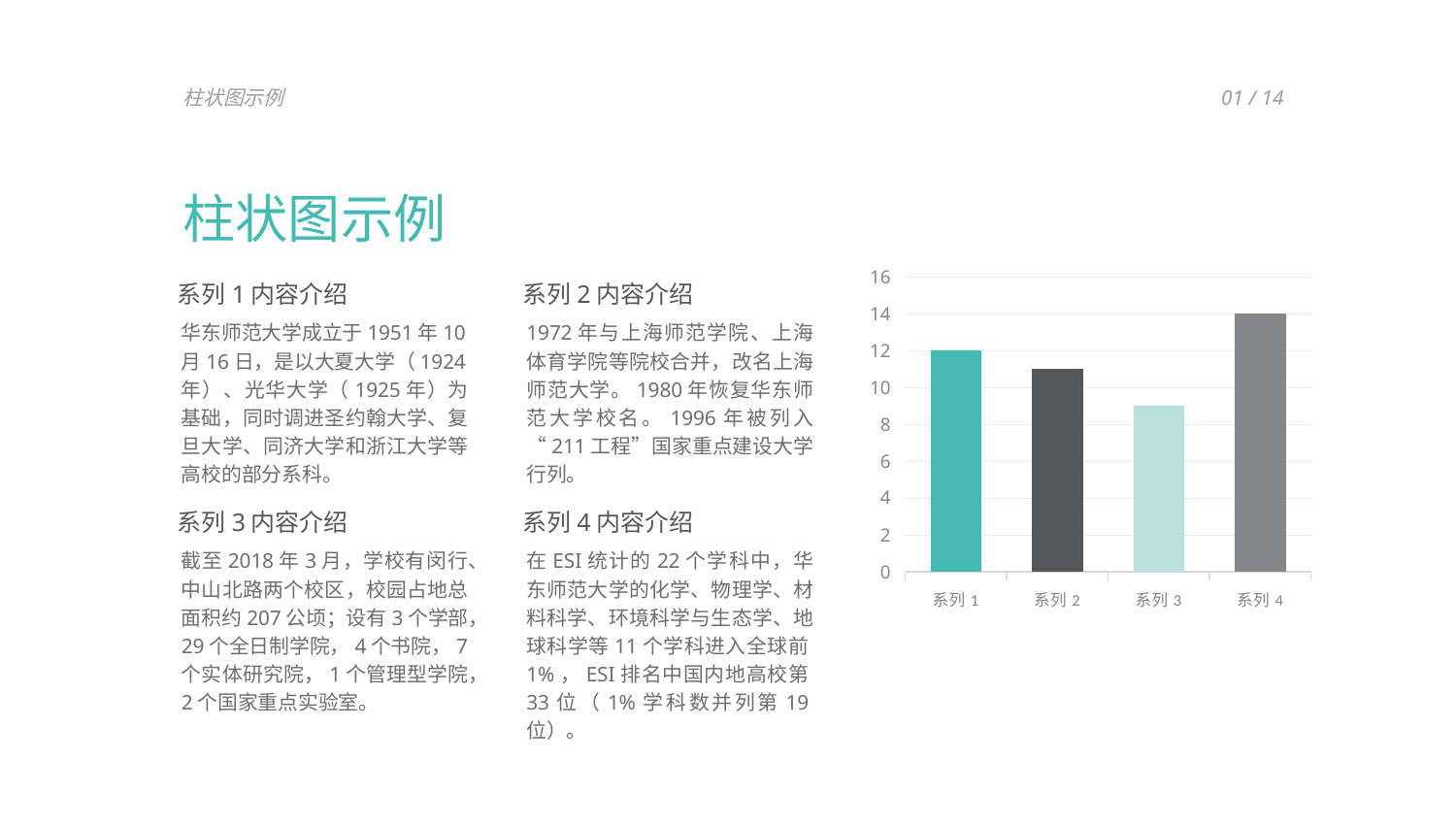
Which is larger, the value for 系列 1 or the value for 系列 3? 系列 1 Is the value for 系列 3 greater or less than 10? less What is the highest value shown on the y axis? 16 How many categories are shown on the x axis of the chart? 4 What is the value for 系列 1? 12 What colour is the bar for 系列 1? Teal What is the difference between the values for 系列 4 and 系列 1? 2 Is the value for 系列 2 greater or less than 10? greater What is the value for 系列 4? 14 What type of chart is shown on the slide? Bar chart Which category has the lowest value? 系列 3 Which category has the highest value? 系列 4